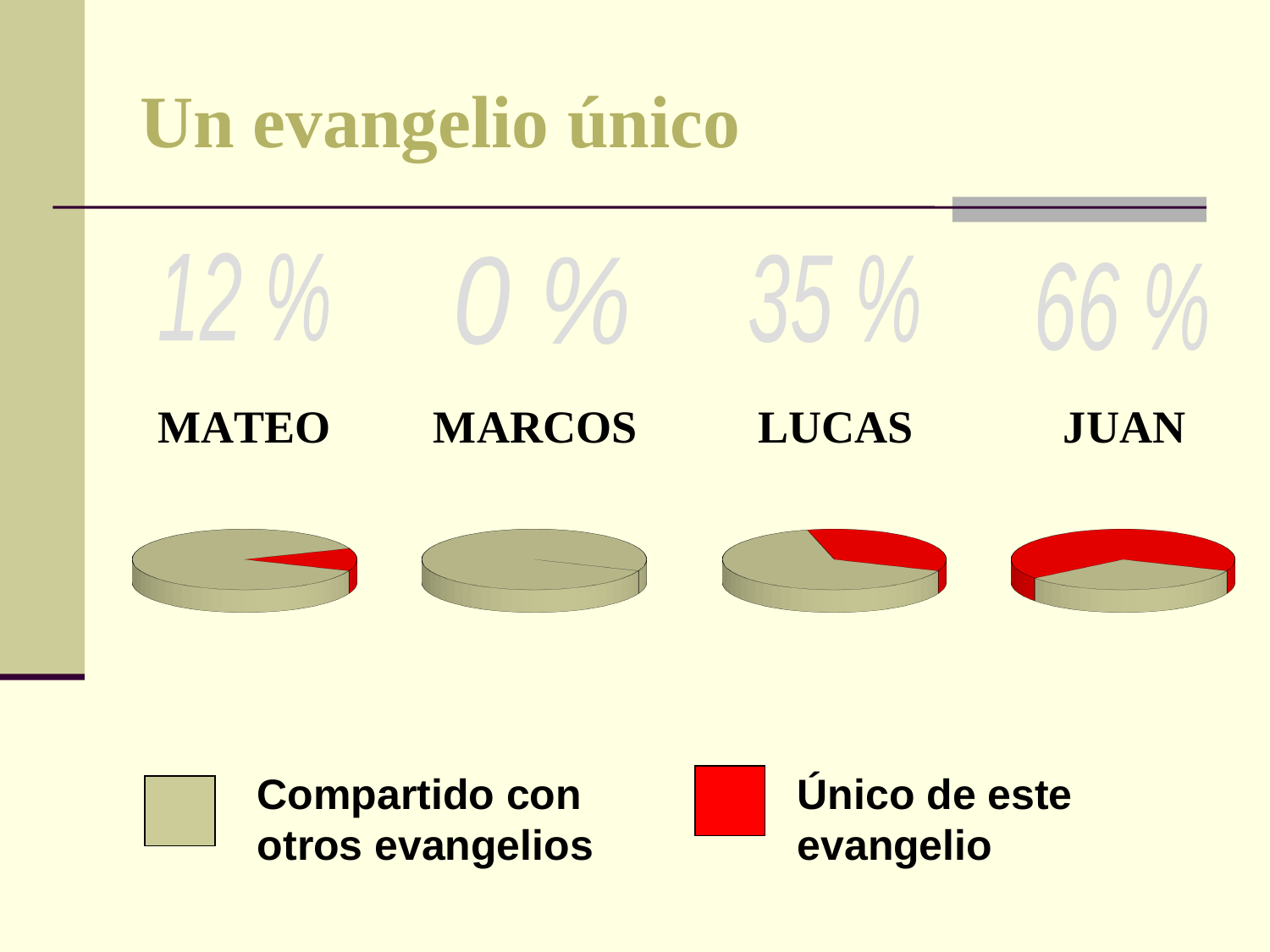
What percentage is shown above the JUAN pie chart? 66 % How many entries does the legend list? 2 What percentage is shown above the MARCOS pie chart? 0 % Which has a larger 'Único de este evangelio' share, MATEO or LUCAS? LUCAS According to the legend, what does the red colour represent? Único de este evangelio What is the difference between the percentages shown for JUAN and LUCAS? 31 % How many pie charts are shown on the slide? 4 What percentage is shown above the LUCAS pie chart? 35 % Which gospel has the largest 'Único de este evangelio' share? JUAN What kind of charts are shown on the slide? Pie charts What percentage is shown above the MATEO pie chart? 12 % Which gospel has the smallest 'Único de este evangelio' share? MARCOS